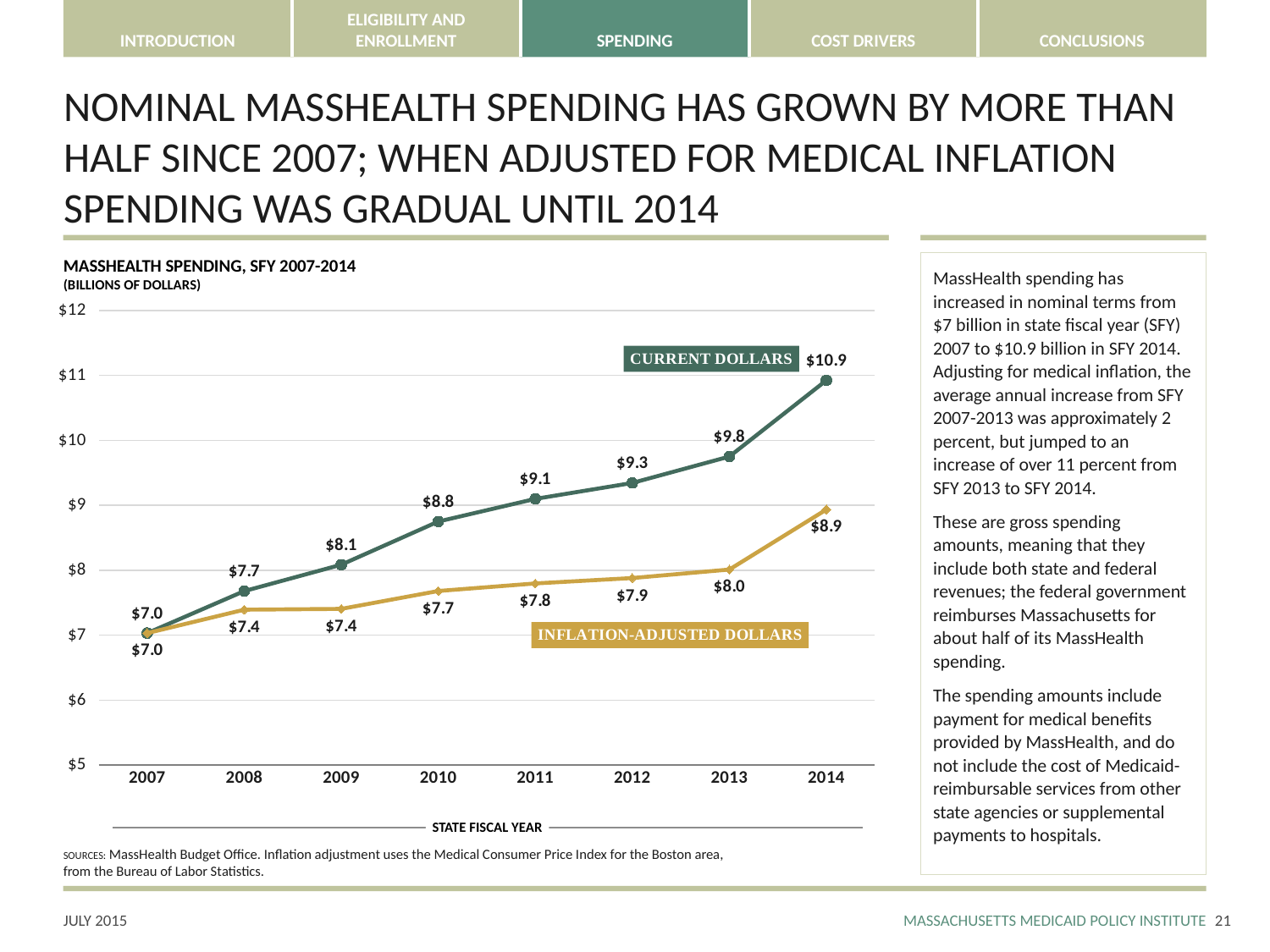
What type of chart is used to show MassHealth spending? Line chart Is current-dollar spending in SFY 2013 greater or less than $10? less What is the difference between current-dollar and inflation-adjusted spending in SFY 2014? $2.0 How many data series does the chart show? 2 What was MassHealth spending in current dollars in SFY 2010? $8.8 What was MassHealth spending in inflation-adjusted dollars in SFY 2013? $8.0 In which state fiscal year was current-dollar spending lowest? 2007 In which state fiscal year was inflation-adjusted spending highest? 2014 What was MassHealth spending in current dollars in SFY 2014? $10.9 Does current-dollar spending rise or fall from 2007 to 2014? Rise Which was larger in SFY 2012: current-dollar spending or inflation-adjusted spending? Current dollars How many state fiscal years are shown on the x axis? 8